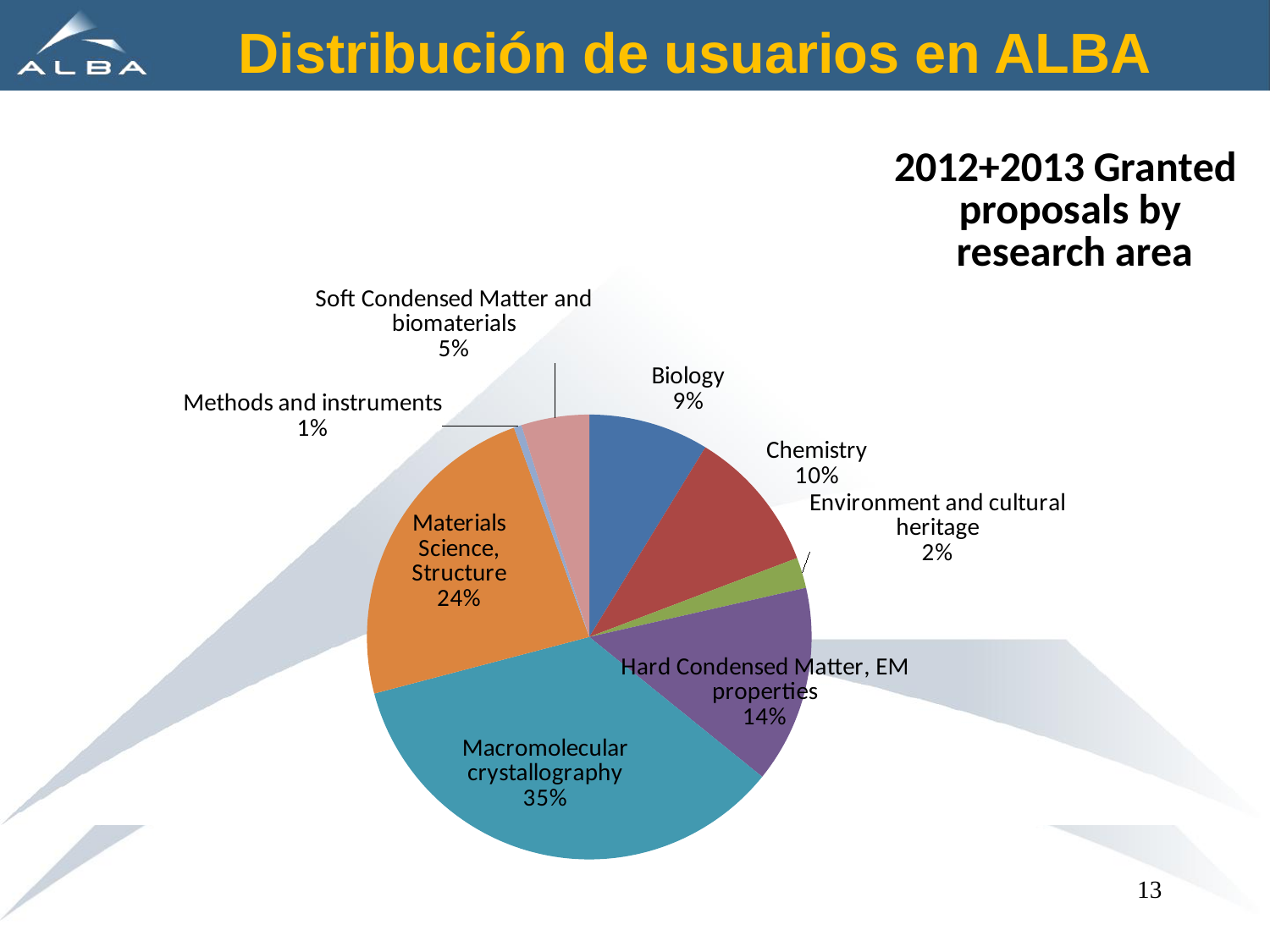
What share of granted proposals is for Environment and cultural heritage? 2% How many research areas are shown in the pie chart? 8 What is the title of the pie chart? 2012+2013 Granted proposals by research area What share of granted proposals is for Macromolecular crystallography? 35% What kind of chart is shown on the slide? pie chart Which has a larger share, Biology or Chemistry? Chemistry Which research area has the smallest share of granted proposals? Methods and instruments Which research area has the largest share of granted proposals? Macromolecular crystallography What is the difference in share between Macromolecular crystallography and Materials Science, Structure? 11% What share of granted proposals is for Materials Science, Structure? 24%